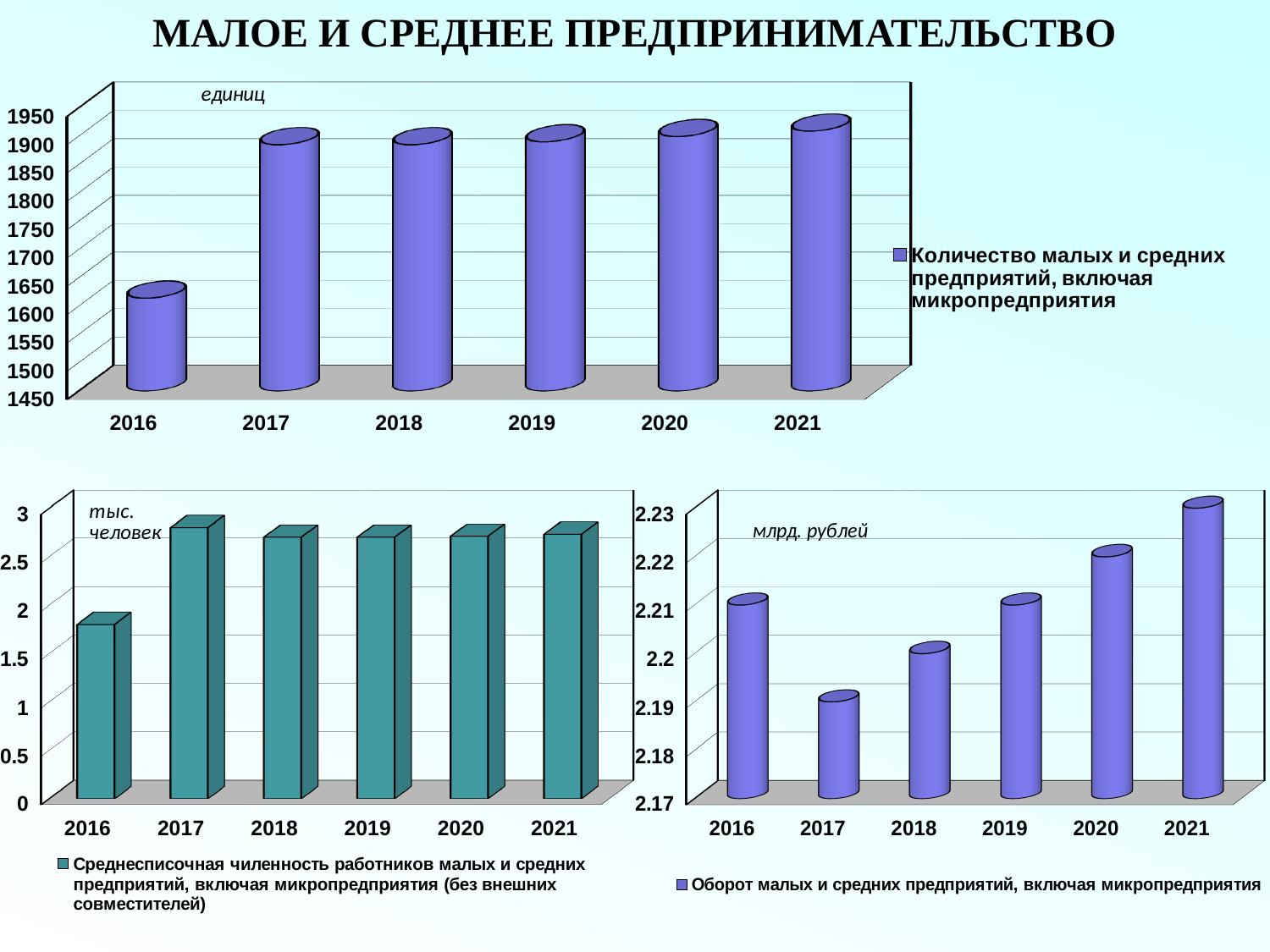
In the top chart (единиц), is the value for 2017 greater or less than 1850? greater In the top chart (единиц), is the value for 2016 greater or less than 1700? less In the top chart (единиц), which year has the lowest value? 2016 In the bottom-left chart (тыс. человек), which year has the lowest value? 2016 In the bottom-left chart (тыс. человек), is the value for 2016 greater or less than 2? less In the bottom-right chart (млрд. рублей), which year has the highest value? 2021 In the bottom-left chart (тыс. человек), which is larger, the value for 2016 or the value for 2017? 2017 In the bottom-right chart (млрд. рублей), which year has the lowest value? 2017 In the bottom-right chart (млрд. рублей), do the values rise or fall from 2017 to 2021? rise What kind of chart is the bottom-right chart (млрд. рублей)? bar chart How many years are shown on the x axis of the top chart (единиц)? 6